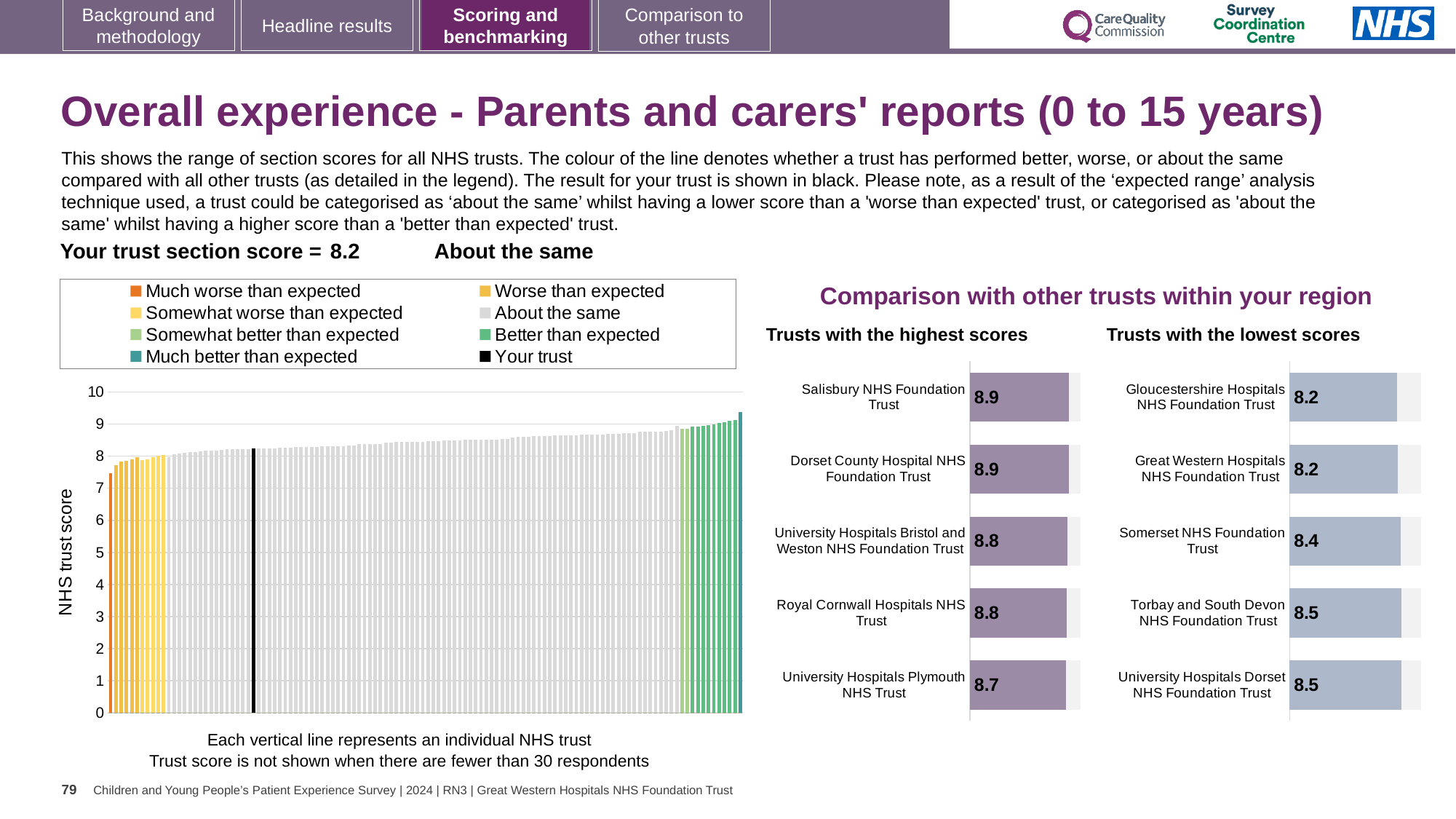
On the 'Trusts with the lowest scores' chart, what is the score for Somerset NHS Foundation Trust? 8.4 What kind of chart is the 'NHS trust score' chart on the left of the slide? bar chart On the 'Trusts with the highest scores' chart, which trust has the lowest score? University Hospitals Plymouth NHS Trust On the 'Trusts with the highest scores' chart, what is the score for Salisbury NHS Foundation Trust? 8.9 On the 'NHS trust score' chart, do the bar heights rise or fall from left to right? rise On the 'NHS trust score' chart, what is the section score for your trust (the black bar)? 8.2 On the 'NHS trust score' chart, is the value of the leftmost (orange) bar greater or less than 8? less On the 'NHS trust score' chart, how many entries does the legend list? 8 On the 'NHS trust score' chart, is the value of the rightmost bar greater or less than 9? greater On the 'Trusts with the lowest scores' chart, how many trusts are shown? 5 On the 'Trusts with the lowest scores' chart, which has the larger score: Somerset NHS Foundation Trust or Torbay and South Devon NHS Foundation Trust? Torbay and South Devon NHS Foundation Trust On the 'Trusts with the highest scores' chart, what is the difference between the scores of Salisbury NHS Foundation Trust and University Hospitals Plymouth NHS Trust? 0.2